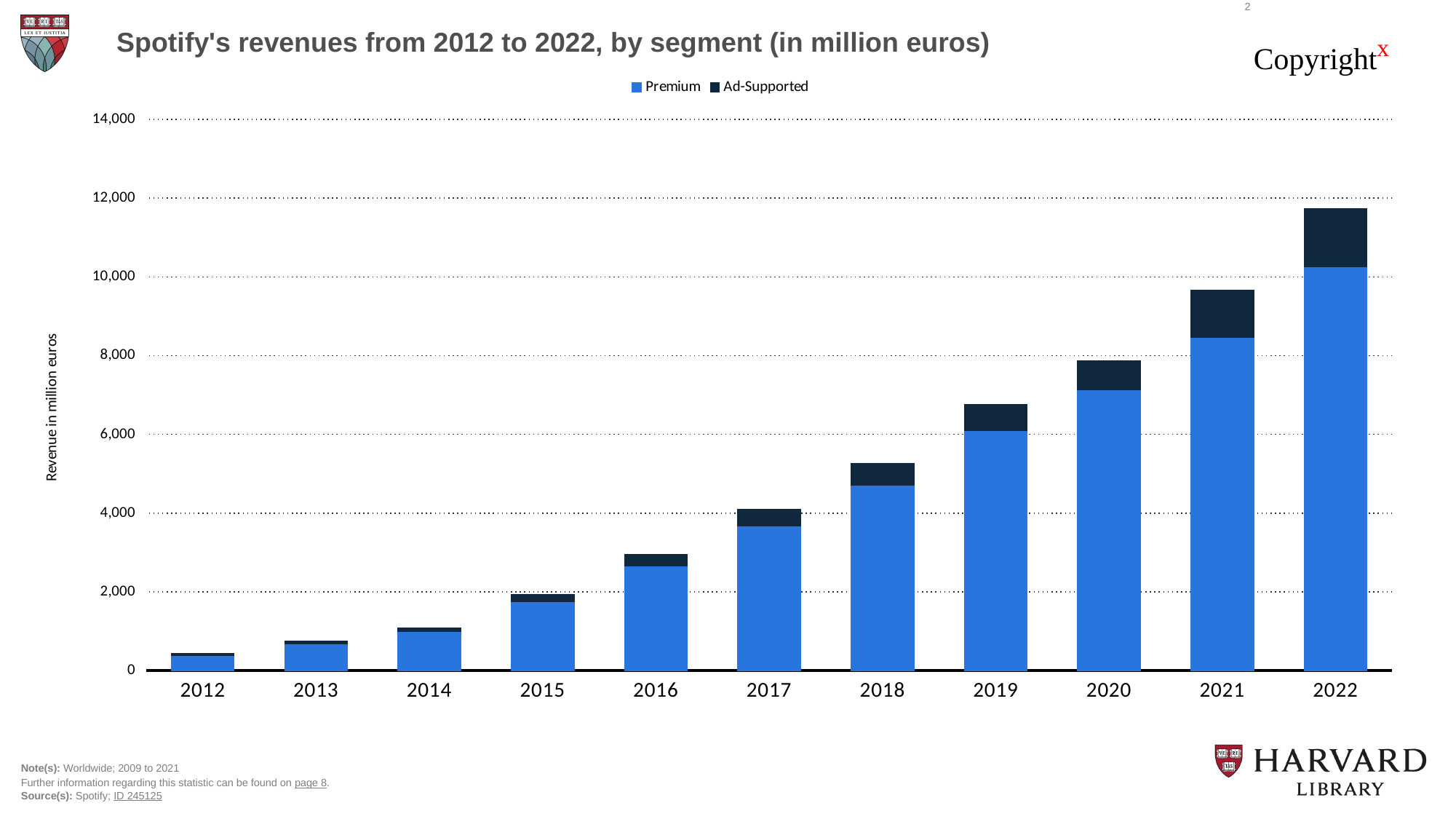
How many series does the legend list? 2 Which year has the lowest total revenue? 2012 Do total revenues rise or fall from 2012 to 2022? rise Which year has the highest total revenue? 2022 How many years are shown on the x axis? 11 What is the title of the chart? Spotify's revenues from 2012 to 2022, by segment (in million euros) Is the total revenue for 2021 greater or less than 10,000? less Is the total revenue for 2016 greater or less than 2,000? greater Is the total revenue for 2022 greater or less than 10,000? greater What kind of chart is shown on the slide? bar chart Which segment is shown in the lighter blue colour? Premium